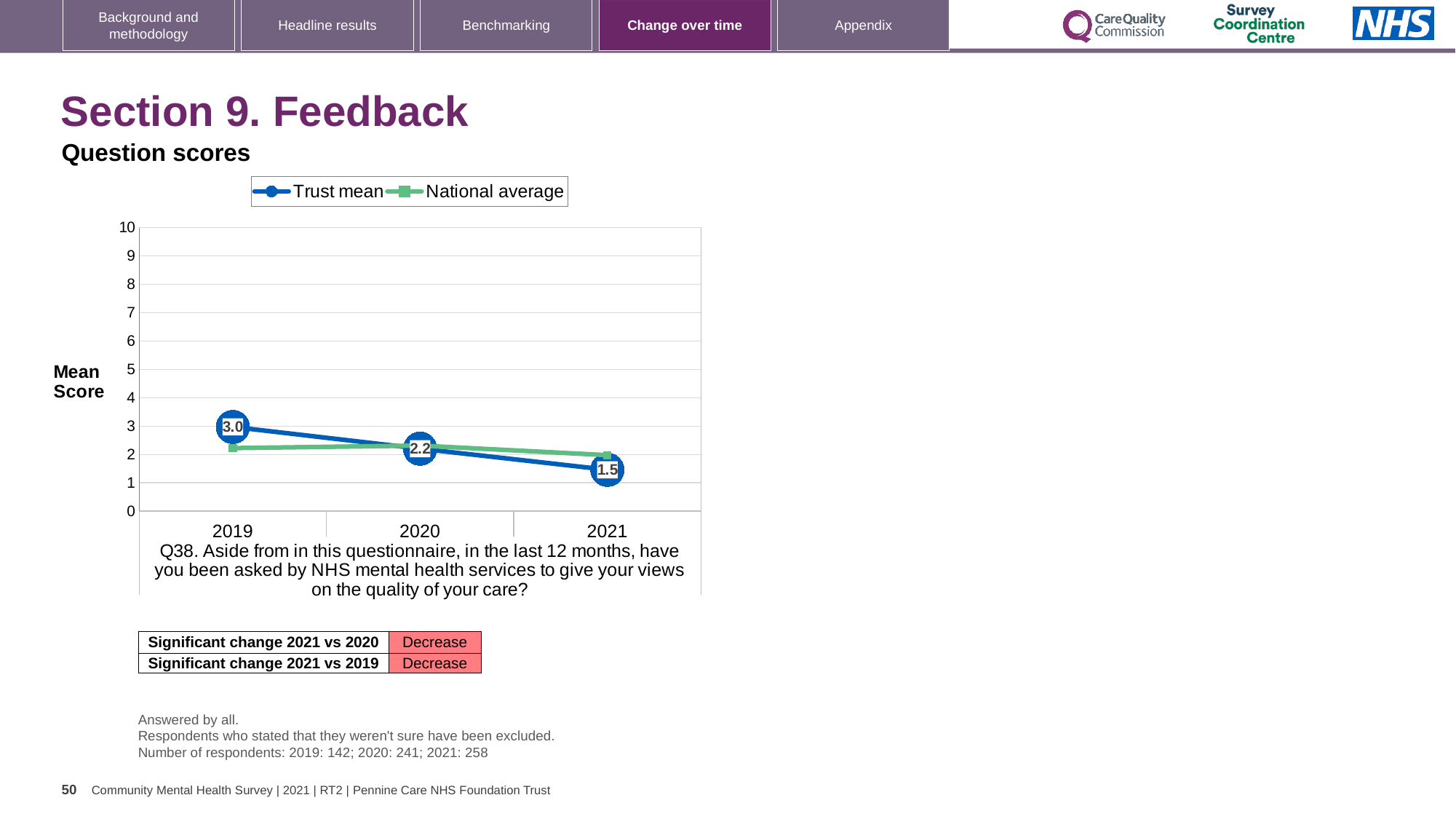
How many series does the legend list? 2 In 2019, which is larger: the Trust mean or the National average? Trust mean What is the Trust mean score for 2019? 3.0 What is the Trust mean score for 2021? 1.5 Is the National average for 2019 greater or less than 3? less What is the Trust mean score for 2020? 2.2 In 2021, which is larger: the Trust mean or the National average? National average In which year is the Trust mean score highest? 2019 Does the Trust mean score rise or fall from 2019 to 2021? fall In which year is the Trust mean score lowest? 2021 What is the difference between the Trust mean score in 2019 and in 2021? 1.5 What kind of chart is shown on the slide? line chart